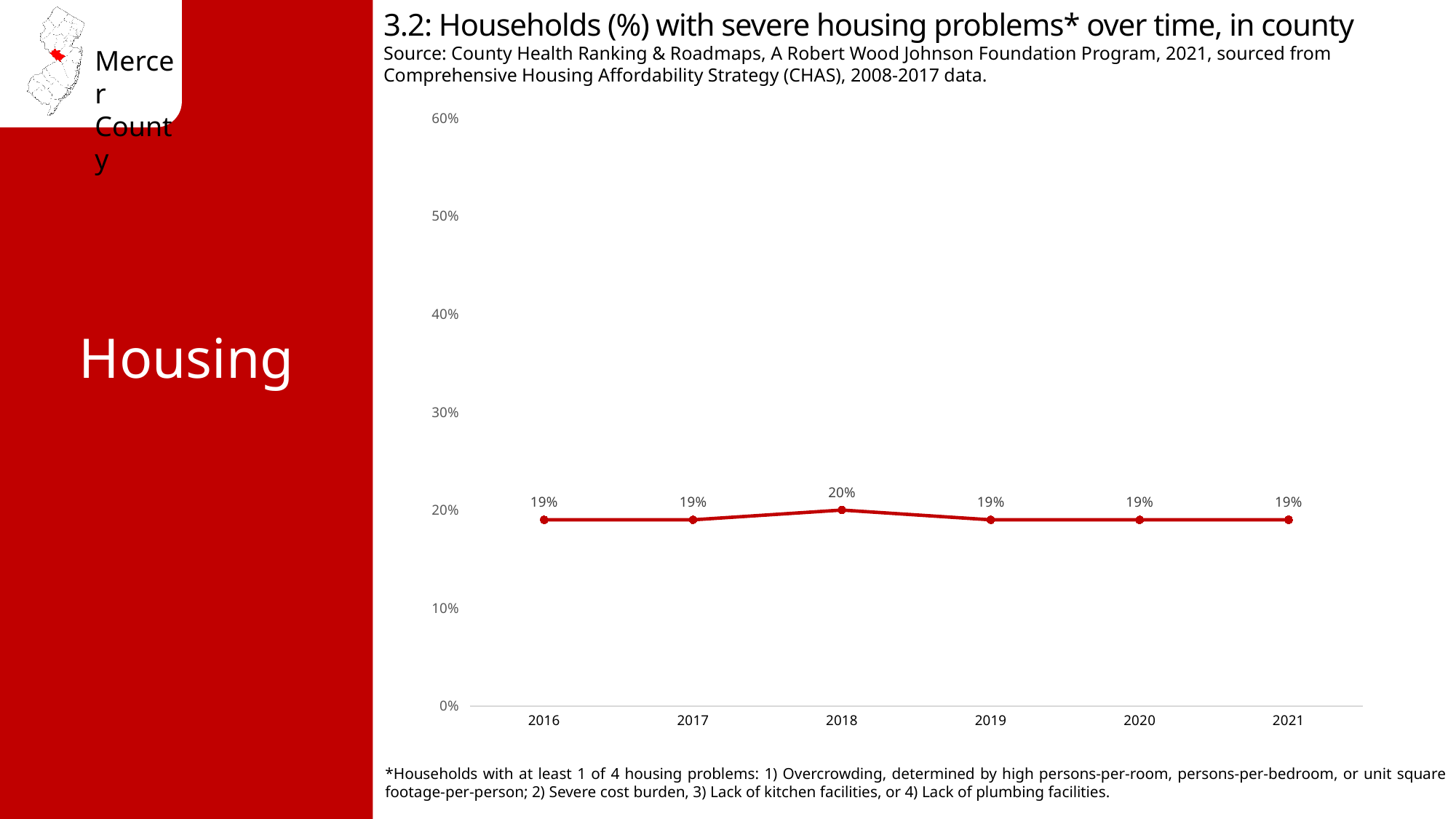
What is the difference between the 2018 value and the 2017 value? 1% What kind of chart is shown on the slide? line chart Which year had the highest percentage of households with severe housing problems? 2018 Does the percentage of households with severe housing problems change much from 2016 to 2021? No, it stays roughly flat at 19%-20% What percentage of households had severe housing problems in 2016? 19% What is the title of the chart? 3.2: Households (%) with severe housing problems* over time, in county What percentage of households had severe housing problems in 2018? 20% What percentage of households had severe housing problems in 2019? 19% What percentage of households had severe housing problems in 2021? 19% Is the value for 2020 greater or less than 10%? greater Is the value for 2018 greater or less than 30%? less How many years are plotted on the chart? 6